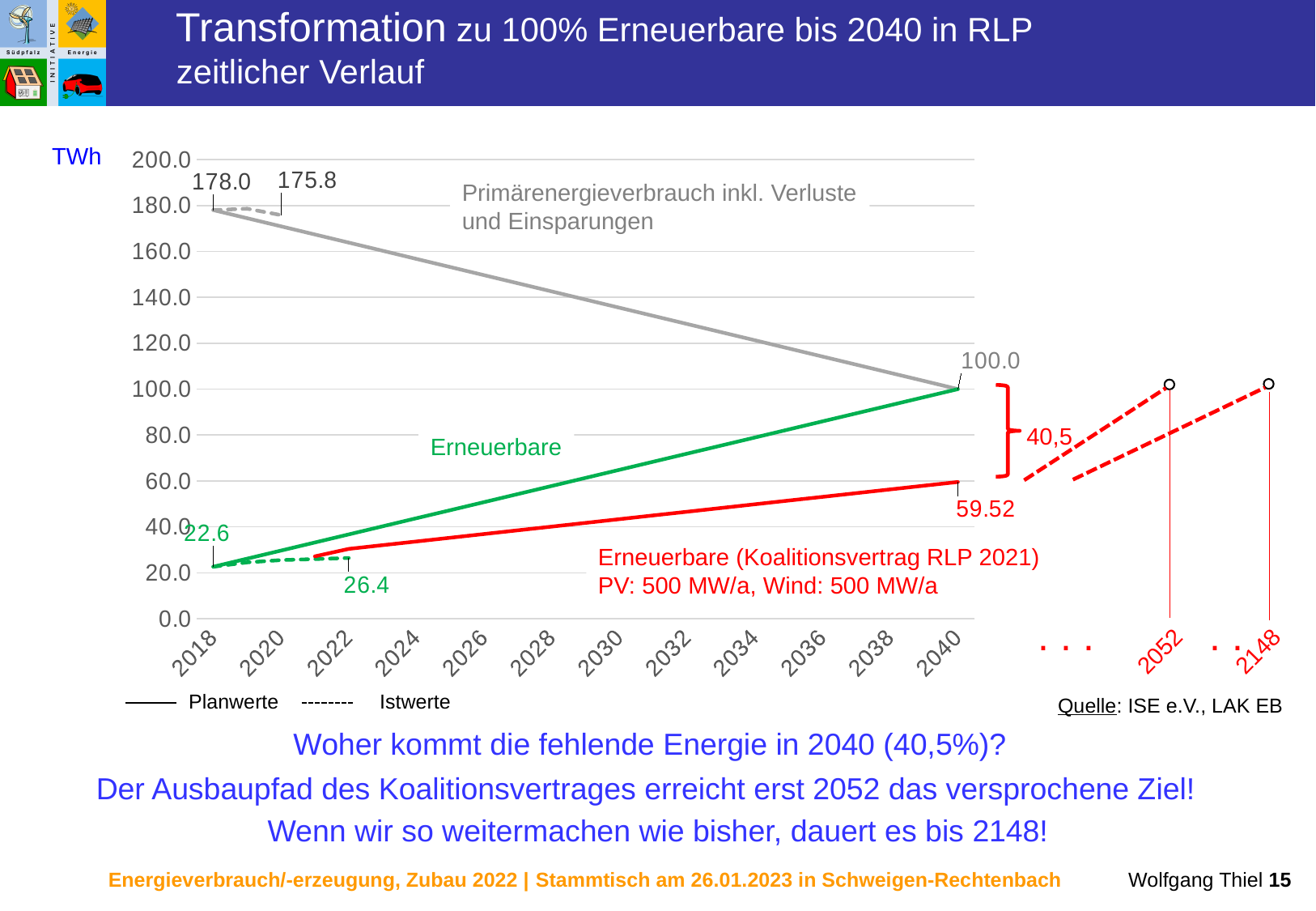
What is the Istwert for Erneuerbare shown at 2022? 26.4 What is the value of Primärenergieverbrauch inkl. Verluste und Einsparungen in 2018? 178.0 By how much does Primärenergieverbrauch decrease from 2018 (178.0) to 2040 (100.0)? 78.0 Is the value of the Erneuerbare (Koalitionsvertrag RLP 2021) line in 2030 greater or less than 60? less What is the value of Erneuerbare in 2018? 22.6 Does the Primärenergieverbrauch line rise or fall from 2018 to 2040? fall What value does the Primärenergieverbrauch line reach in 2040? 100.0 What is the Istwert labelled for Primärenergieverbrauch near 2020? 175.8 In 2040, which is higher: the Erneuerbare Planwerte line or the Erneuerbare (Koalitionsvertrag RLP 2021) line? Erneuerbare Planwerte Does the green Erneuerbare line rise or fall from 2018 to 2040? rise What unit is shown on the y axis of the chart? TWh What value does the Erneuerbare (Koalitionsvertrag RLP 2021) line reach in 2040? 59.52